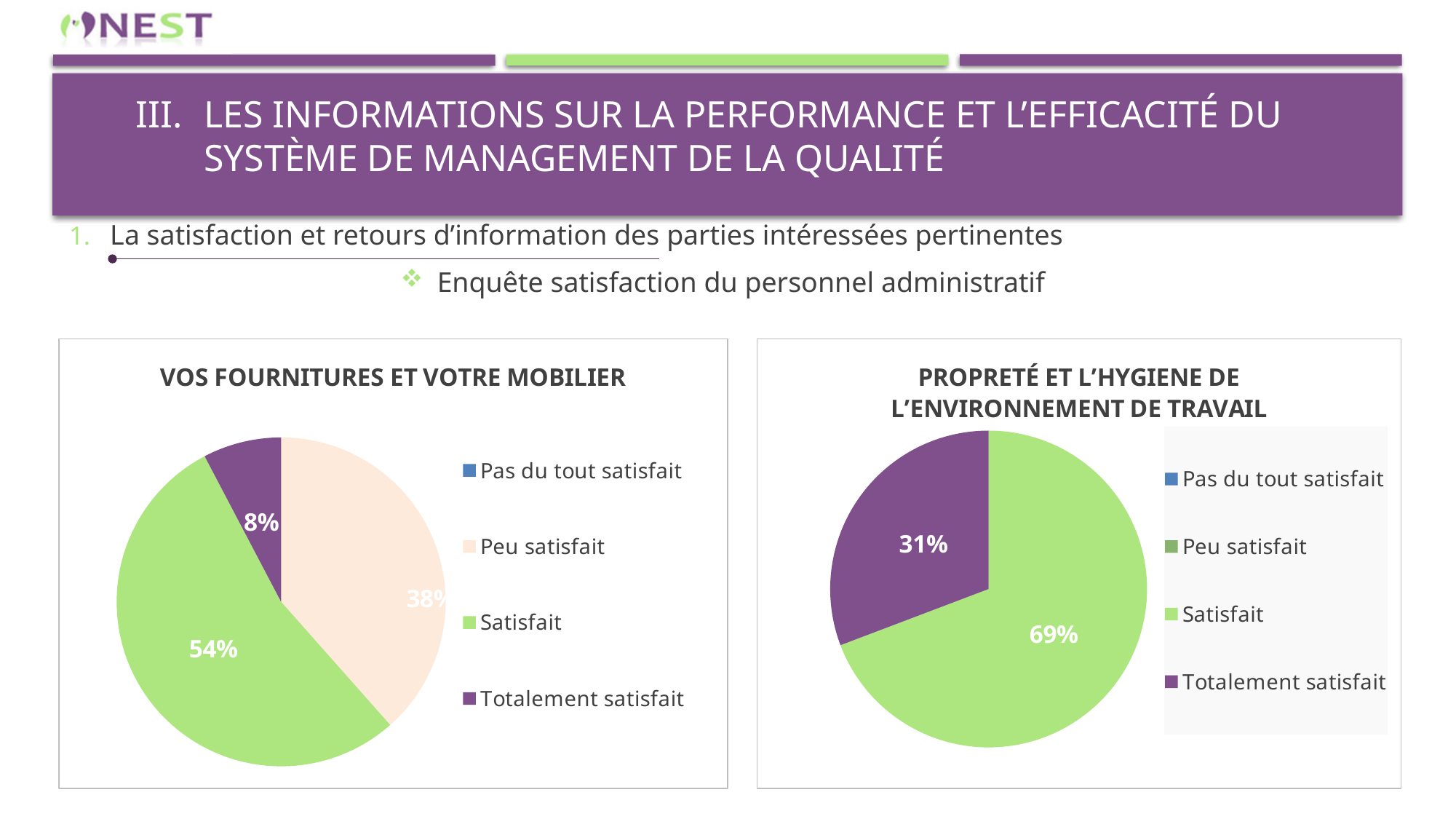
In the 'VOS FOURNITURES ET VOTRE MOBILIER' chart, what share is 'Totalement satisfait'? 8% In the 'PROPRETÉ ET L'HYGIENE DE L'ENVIRONNEMENT DE TRAVAIL' chart, which is larger, 'Satisfait' or 'Totalement satisfait'? Satisfait In the 'VOS FOURNITURES ET VOTRE MOBILIER' chart, what is the difference between the 'Satisfait' and 'Peu satisfait' shares? 16% In the 'PROPRETÉ ET L'HYGIENE DE L'ENVIRONNEMENT DE TRAVAIL' chart, what share is 'Satisfait'? 69% In the 'PROPRETÉ ET L'HYGIENE DE L'ENVIRONNEMENT DE TRAVAIL' chart, what colour is the 'Totalement satisfait' slice? Purple In the 'PROPRETÉ ET L'HYGIENE DE L'ENVIRONNEMENT DE TRAVAIL' chart, what is the difference between the 'Satisfait' and 'Totalement satisfait' shares? 38% In the 'PROPRETÉ ET L'HYGIENE DE L'ENVIRONNEMENT DE TRAVAIL' chart, what share is 'Totalement satisfait'? 31% What kind of chart is 'VOS FOURNITURES ET VOTRE MOBILIER'? Pie chart In the 'VOS FOURNITURES ET VOTRE MOBILIER' chart, how many entries does the legend list? 4 In the 'VOS FOURNITURES ET VOTRE MOBILIER' chart, which category has the largest share? Satisfait